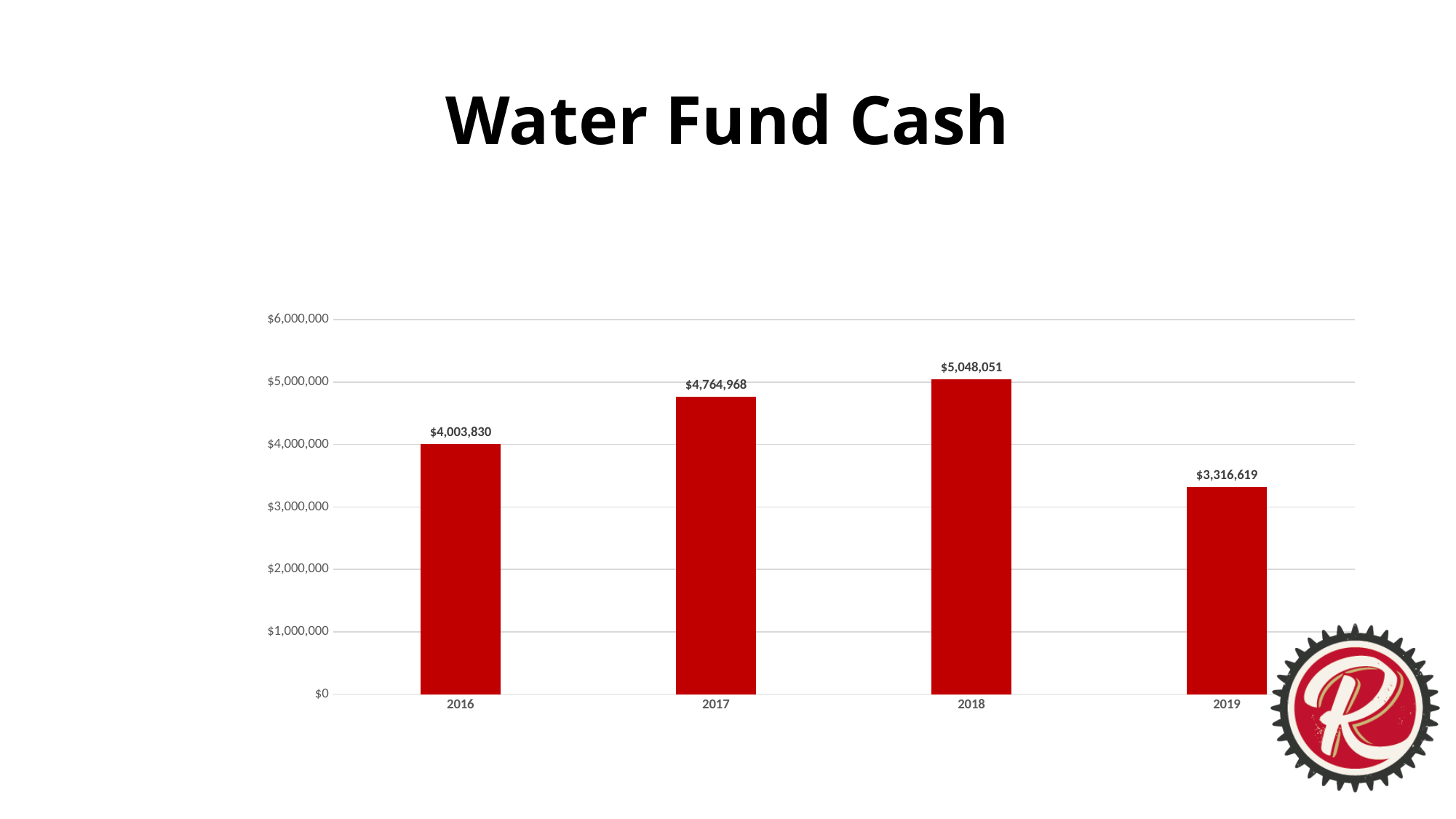
What is the Water Fund Cash value for 2019? $3,316,619 How many years are shown on the chart? 4 Which year has the lowest Water Fund Cash? 2019 Is the Water Fund Cash value for 2018 greater or less than $5,000,000? greater Which year has more Water Fund Cash, 2016 or 2019? 2016 What is the Water Fund Cash value for 2017? $4,764,968 By how much did Water Fund Cash fall from 2018 to 2019? $1,731,432 Which year has the highest Water Fund Cash? 2018 What is the difference between the Water Fund Cash in 2018 and 2017? $283,083 What kind of chart is shown on the slide? Bar chart What is the Water Fund Cash value for 2016? $4,003,830 What is the title of the chart? Water Fund Cash